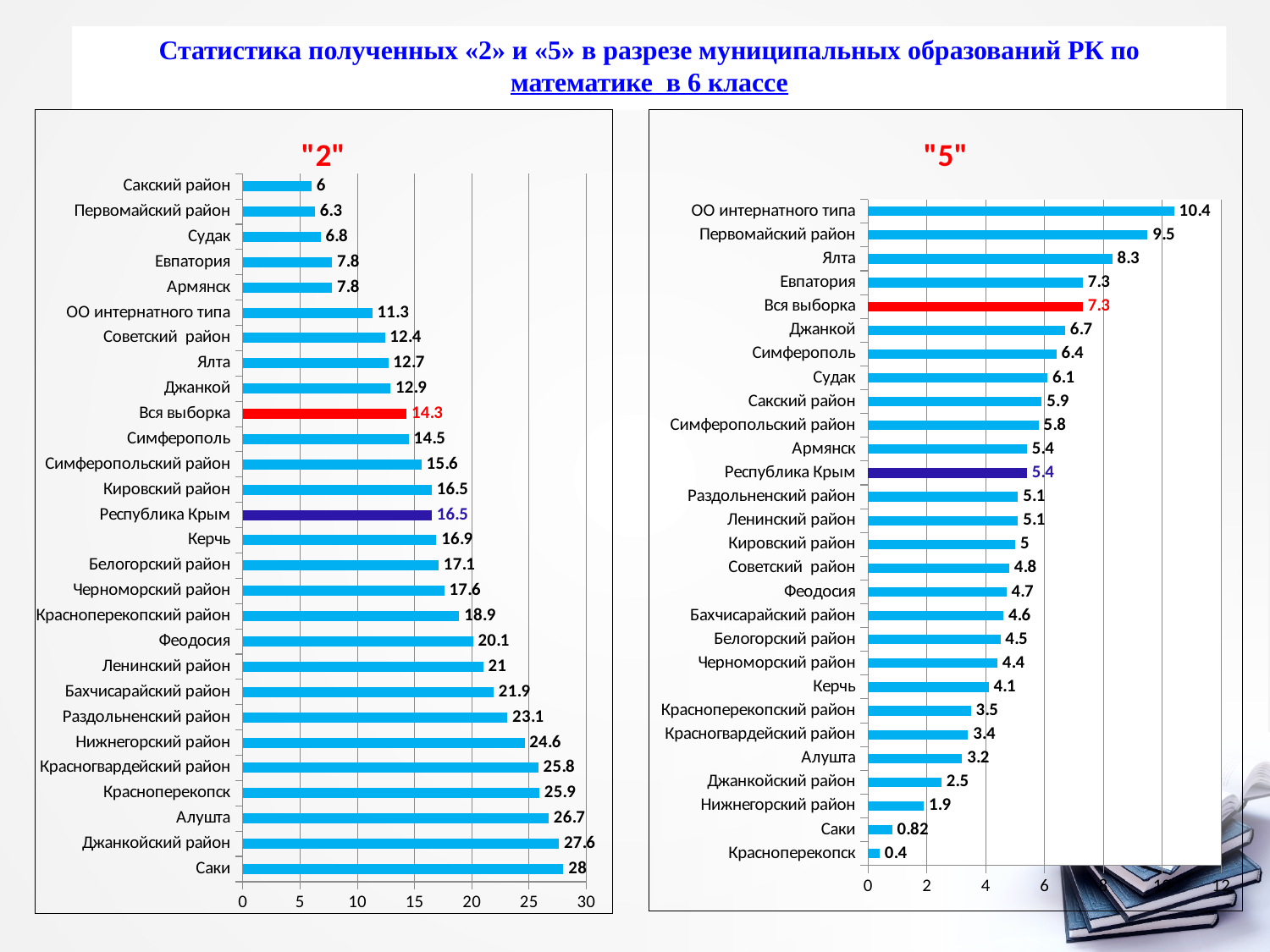
In the chart titled "5", which is larger, the value for Ялта or the value for Евпатория? Ялта In the chart titled "5", what is the value for ОО интернатного типа? 10.4 In the chart titled "2", what is the difference between the values for Саки and Сакский район? 22 In the chart titled "2", which category has the lowest value? Сакский район In the chart titled "2", what is the value for Саки? 28 In the chart titled "2", what colour is the bar for Вся выборка? Red In the chart titled "2", what is the value for Вся выборка? 14.3 In the chart titled "5", what is the difference between the values for Первомайский район and Ялта? 1.2 In the chart titled "5", what is the value for Республика Крым? 5.4 In the chart titled "5", which category has the lowest value? Красноперекопск What kind of chart is the chart titled "2"? Bar chart In the chart titled "2", how many categories are plotted? 28